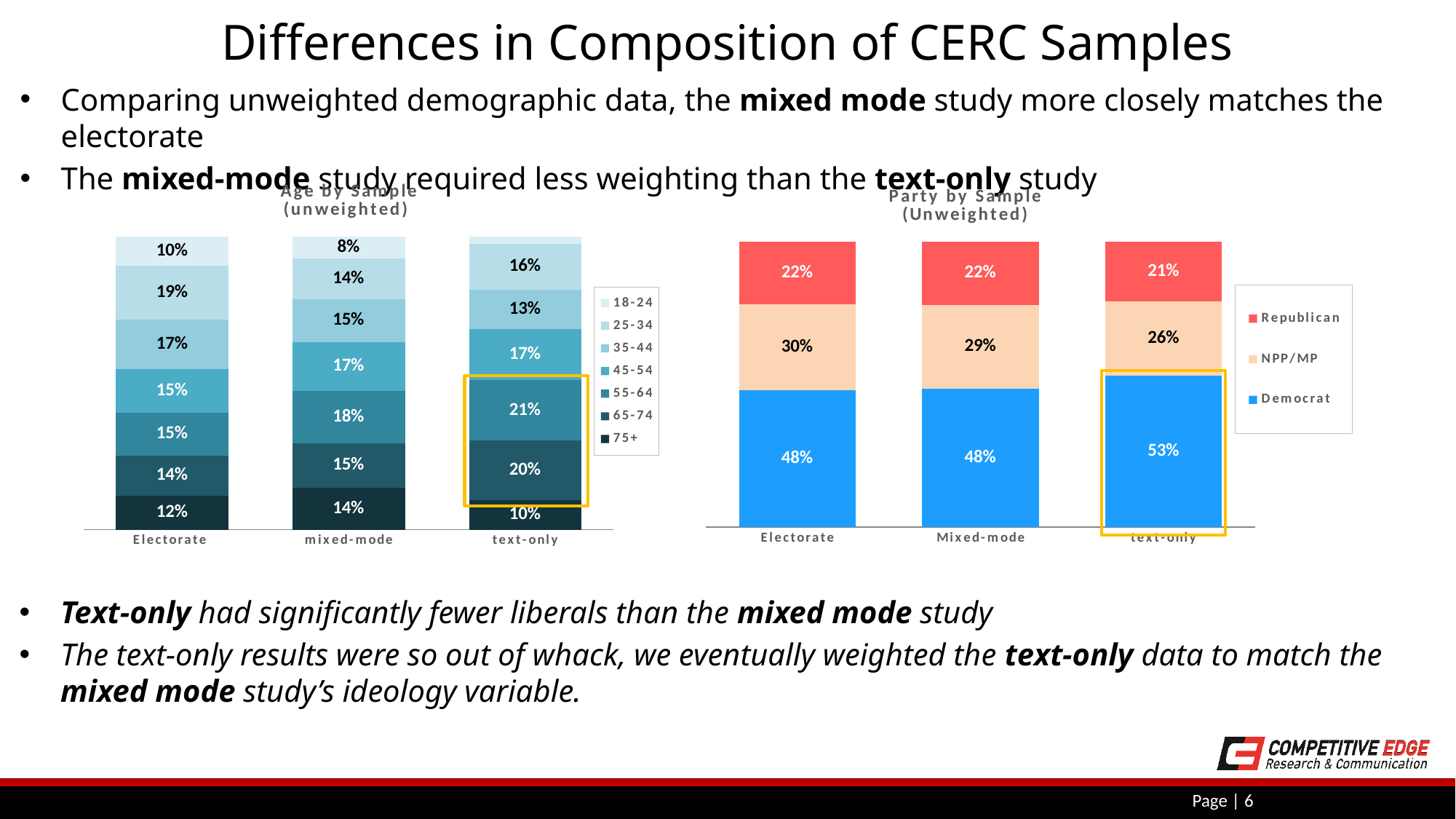
How many samples (bars) are shown in the Party by Sample (Unweighted) chart? 3 In the Party by Sample (Unweighted) chart, is the NPP/MP share larger for the Electorate or for the text-only sample? Electorate In the Party by Sample (Unweighted) chart, what is the Democrat share for the text-only sample? 53% What kind of chart is the Age by Sample (unweighted) chart? Stacked bar chart In the Party by Sample (Unweighted) chart, how many percentage points higher is the Democrat share for text-only than for the Electorate? 5 percentage points In the Party by Sample (Unweighted) chart, which sample has the highest Democrat share? text-only In the Age by Sample (unweighted) chart, what is the value of the 75+ segment (the darkest, bottom segment) for the mixed-mode sample? 14% In the Age by Sample (unweighted) chart, what is the value of the 18-24 segment (the lightest, top segment) for the Electorate? 10% In the Party by Sample (Unweighted) chart, what is the Republican share for the Mixed-mode sample? 22% How many age groups does the legend of the Age by Sample (unweighted) chart list? 7 How many series does the legend of the Party by Sample (Unweighted) chart list? 3 In the Party by Sample (Unweighted) chart, what is the NPP/MP share for the Electorate? 30%